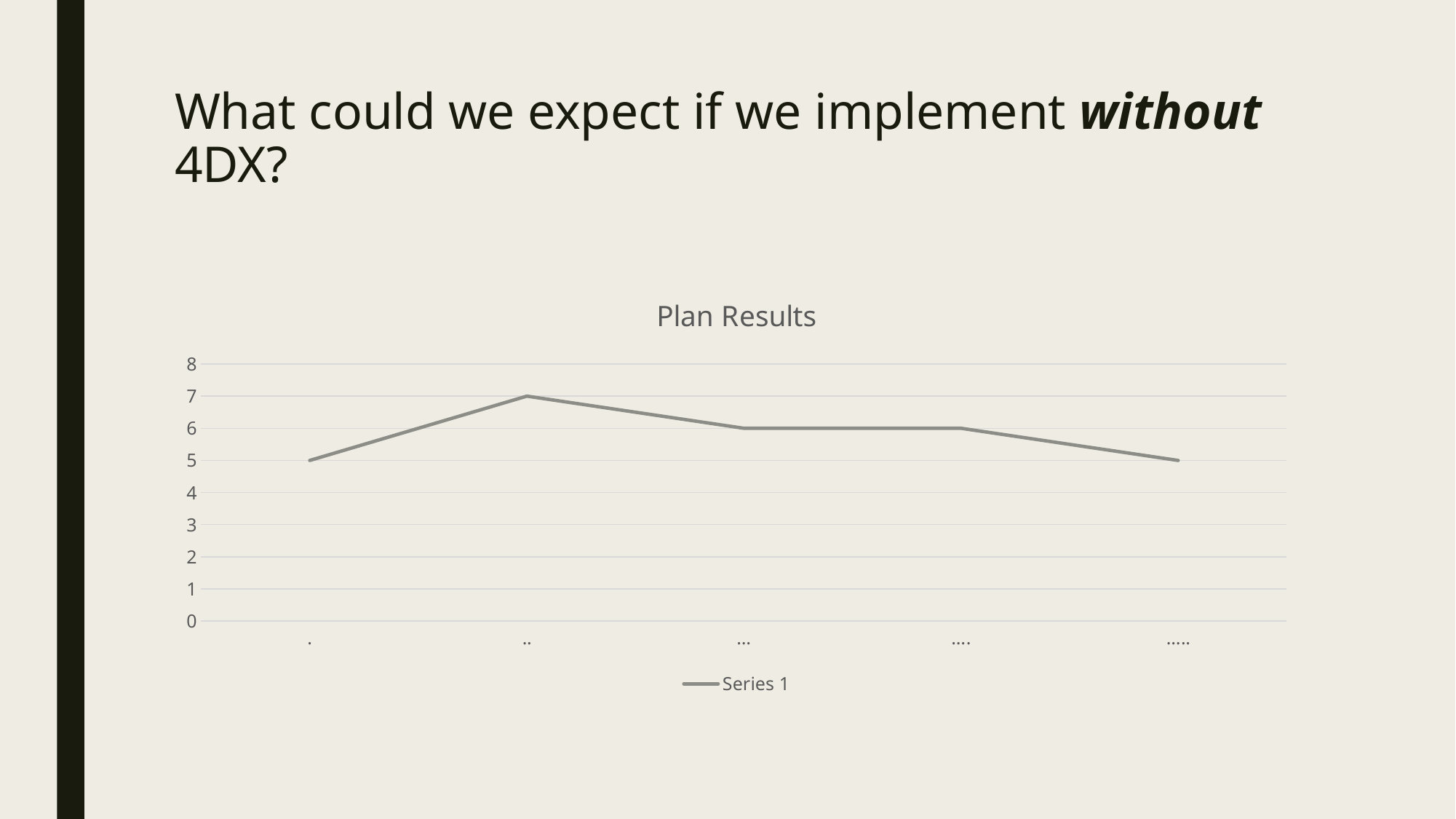
What is the value of the last point on the line? 5 How many data points are plotted on the line? 5 What is the value of the third point on the line? 6 What is the difference between the highest value and the first value on the line? 2 Which point on the line has the highest value? the second point How many series does the legend list? 1 What is the value of the first point on the line? 5 Is the value of the second point greater or less than 6? greater What is the value of the second point on the line? 7 What kind of chart is shown on the slide? line chart What is the title of the chart? Plan Results What is the name of the series in the legend? Series 1